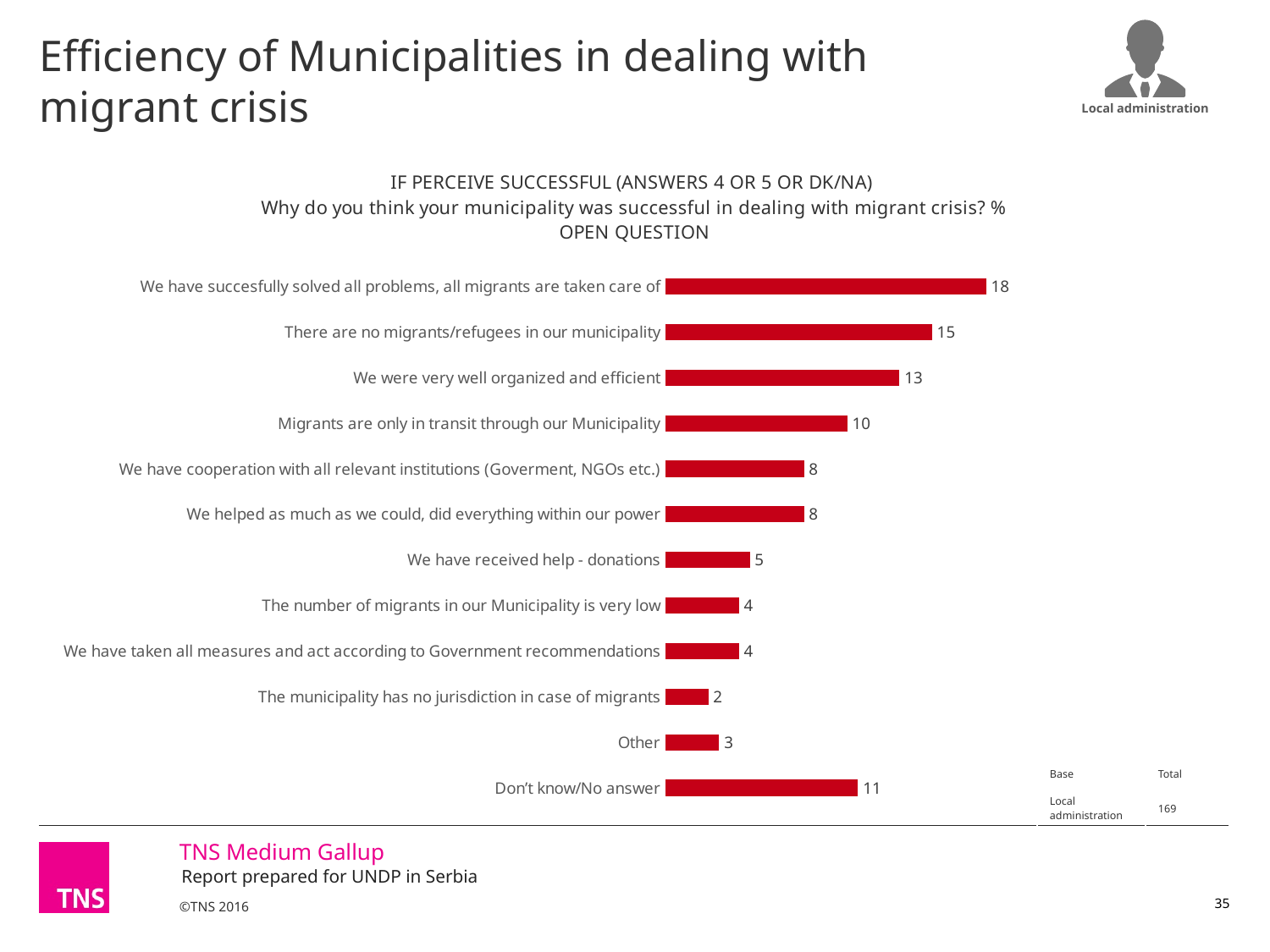
What is the value for "There are no migrants/refugees in our municipality"? 15 What is the value for "We have received help - donations"? 5 What is the value for "We have cooperation with all relevant institutions (Goverment, NGOs etc.)"? 8 What kind of chart is shown on the slide? Bar chart Which is larger: the value for "Other" or the value for "The municipality has no jurisdiction in case of migrants"? Other Which category has the highest value? We have succesfully solved all problems, all migrants are taken care of What is the difference between the values for "We were very well organized and efficient" and "Migrants are only in transit through our Municipality"? 3 How many categories are shown in the chart? 12 What is the value for "We have succesfully solved all problems, all migrants are taken care of"? 18 Which category has the lowest value? The municipality has no jurisdiction in case of migrants What is the value for "Don't know/No answer"? 11 What is the base (number of respondents) shown for Local administration? 169